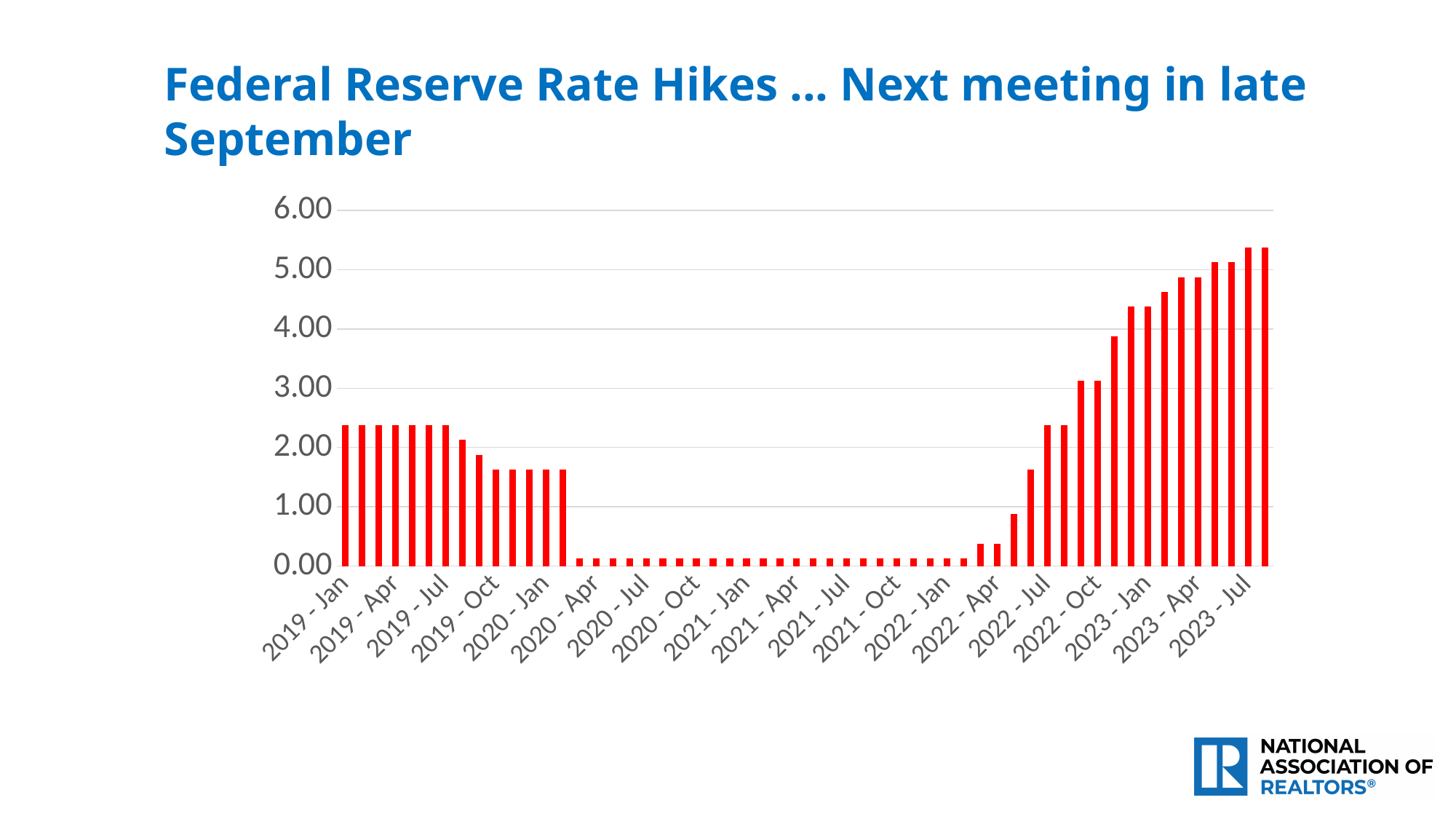
Which is larger, the value for 2020 - Jul or the value for 2019 - Jan? 2019 - Jan What colour are the bars in the chart? red Do the values rise or fall from 2022 - Apr to 2023 - Jul? rise What kind of chart is shown on the slide? bar chart What is the title of the chart on the slide? Federal Reserve Rate Hikes … Next meeting in late September Is the value for 2023 - Jan greater or less than 4.00? greater Do the values rise or fall from 2019 - Jul to 2020 - Apr? fall Is the value for 2020 - Jul greater or less than 1.00? less Is the value for 2023 - Jul greater or less than 5.00? greater Which is larger, the value for 2019 - Jan or the value for 2023 - Jul? 2023 - Jul